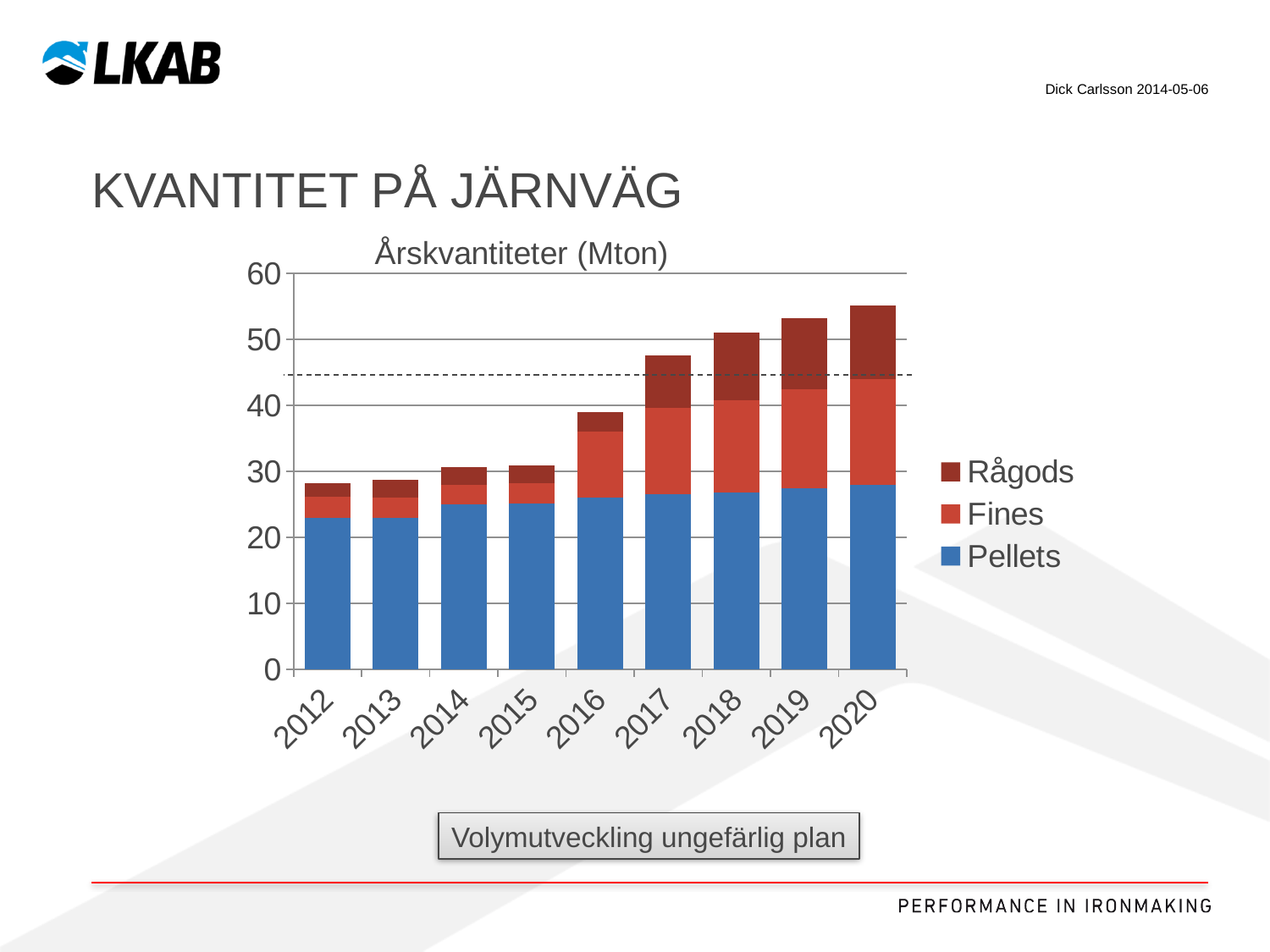
Is the total bar for 2012 greater or less than 30? less Which year has the highest total bar in the chart? 2020 Which year has the larger total bar, 2015 or 2017? 2017 How many series does the chart legend list? 3 Is the Pellets value for 2012 greater or less than 20? greater How many years are shown on the x axis of the chart? 9 Is the total bar for 2020 greater or less than 50? greater Do the total annual quantities generally rise or fall from 2012 to 2020? Rise What are the three series listed in the chart legend? Rågods, Fines, Pellets What kind of chart is shown on the slide? Stacked bar chart What is the title of the chart? Årskvantiteter (Mton)